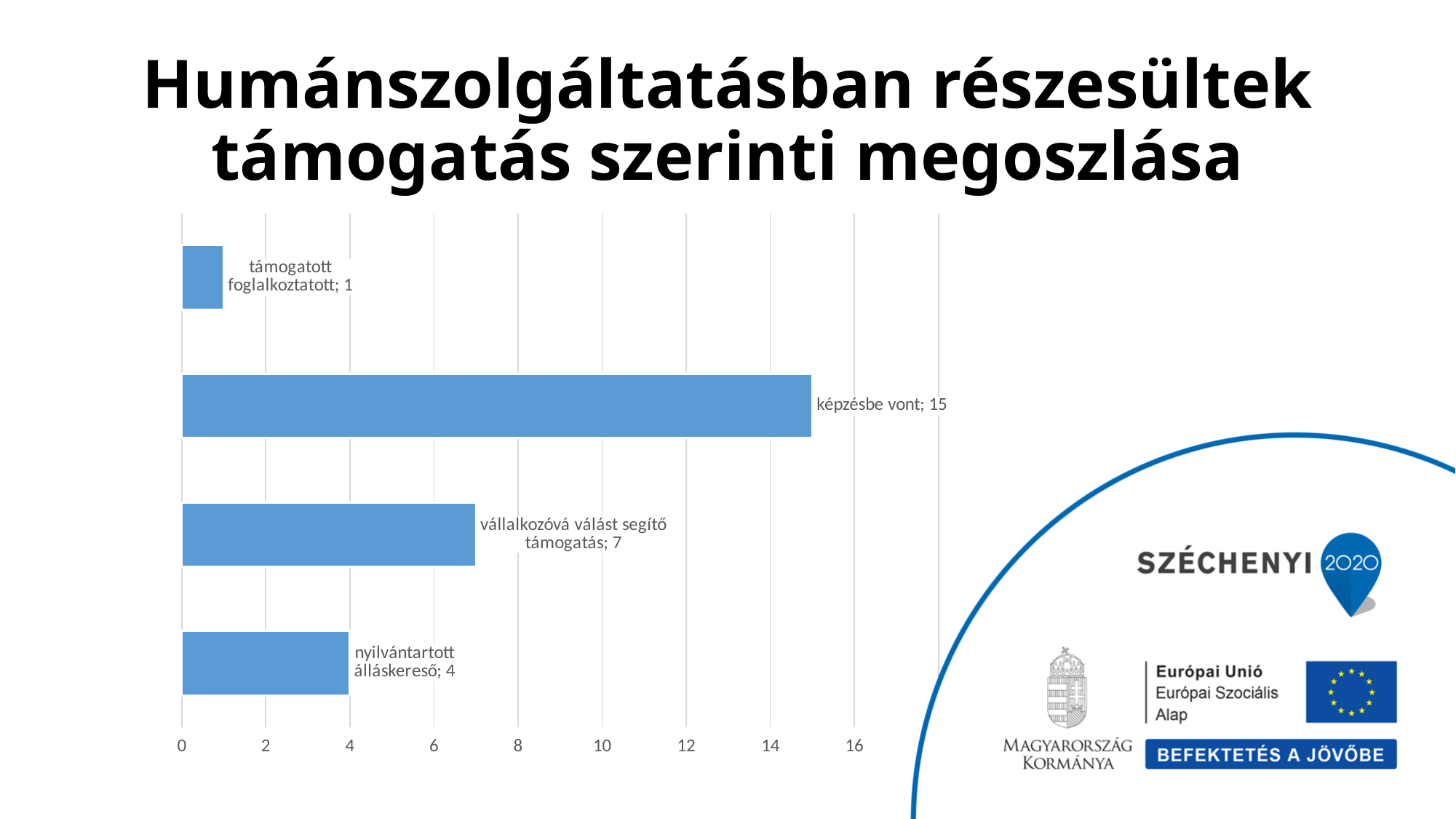
Which is larger: the value for "nyilvántartott álláskereső" or the value for "vállalkozóvá válást segítő támogatás"? vállalkozóvá válást segítő támogatás What is the value for "nyilvántartott álláskereső"? 4 Is the value for "képzésbe vont" greater or less than 10? greater What is the title of the slide containing the chart? Humánszolgáltatásban részesültek támogatás szerinti megoszlása Which category has the highest value? képzésbe vont Which category has the lowest value? támogatott foglalkoztatott How many categories are shown in the chart? 4 What is the value for "vállalkozóvá válást segítő támogatás"? 7 What is the difference between the values for "képzésbe vont" and "vállalkozóvá válást segítő támogatás"? 8 What is the value for "támogatott foglalkoztatott"? 1 What is the value for "képzésbe vont"? 15 What kind of chart is shown on the slide? bar chart